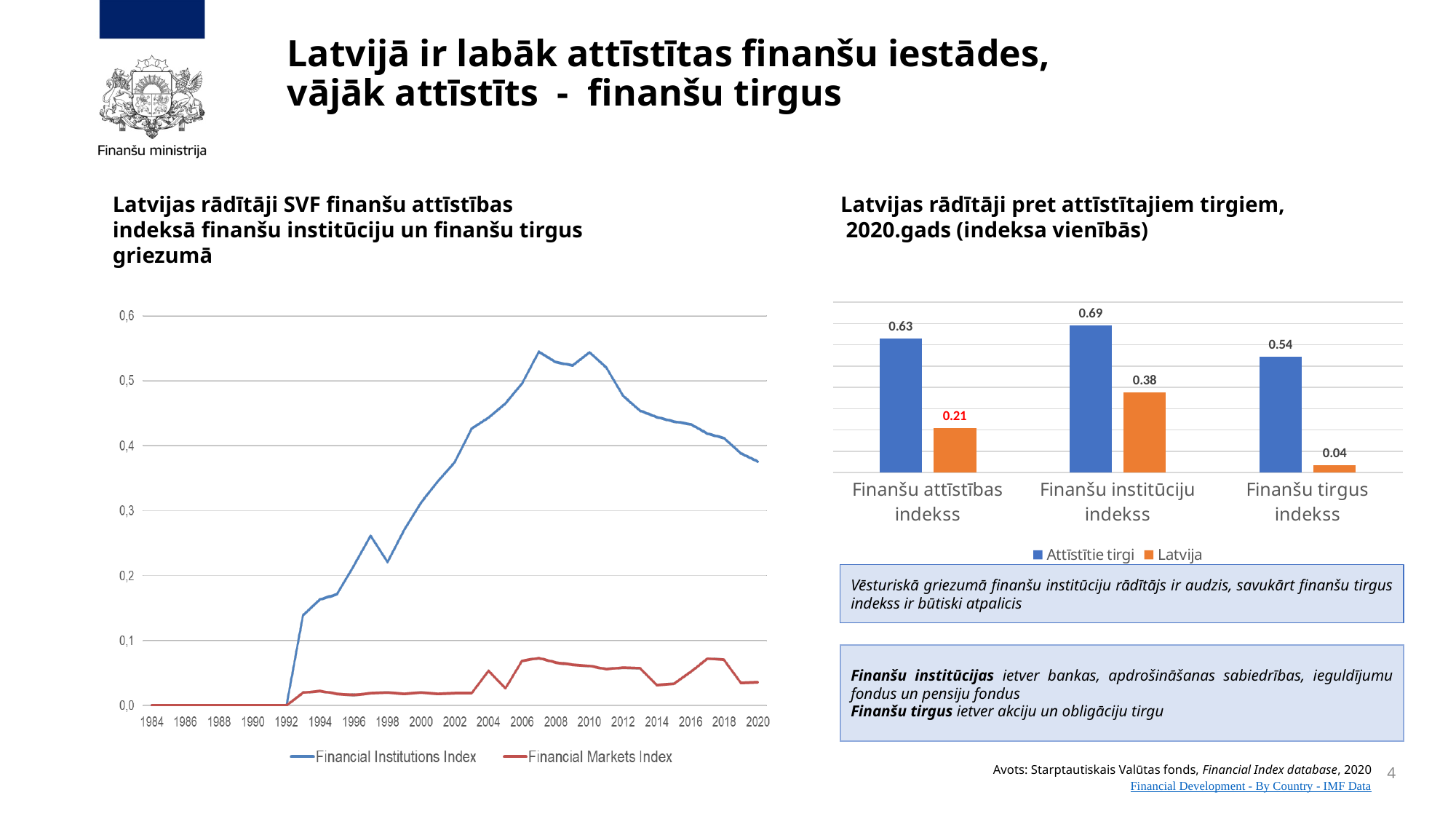
In the right-hand chart (Latvijas rādītāji pret attīstītajiem tirgiem, 2020.gads), what is the value for Latvija in the Finanšu attīstības indekss category? 0.21 In the right-hand chart (Latvijas rādītāji pret attīstītajiem tirgiem, 2020.gads), what is the difference between Attīstītie tirgi and Latvija in the Finanšu tirgus indekss category? 0.50 In the left-hand chart (Latvijas rādītāji SVF finanšu attīstības indeksā), which series is higher in 2010, Financial Institutions Index or Financial Markets Index? Financial Institutions Index In the right-hand chart (Latvijas rādītāji pret attīstītajiem tirgiem, 2020.gads), what is the value for Latvija in the Finanšu tirgus indekss category? 0.04 In the right-hand chart (Latvijas rādītāji pret attīstītajiem tirgiem, 2020.gads), what is the value for Attīstītie tirgi in the Finanšu institūciju indekss category? 0.69 In the right-hand chart (Latvijas rādītāji pret attīstītajiem tirgiem, 2020.gads), which category has the highest value for Attīstītie tirgi? Finanšu institūciju indekss In the left-hand chart (Latvijas rādītāji SVF finanšu attīstības indeksā), is the value of the Financial Institutions Index in 2020 greater or less than 0.3? greater In the right-hand chart (Latvijas rādītāji pret attīstītajiem tirgiem, 2020.gads), what is the difference between Attīstītie tirgi and Latvija in the Finanšu institūciju indekss category? 0.31 What kind of chart is the left-hand chart (Latvijas rādītāji SVF finanšu attīstības indeksā)? Line chart In the right-hand chart (Latvijas rādītāji pret attīstītajiem tirgiem, 2020.gads), which category has the lowest value for Latvija? Finanšu tirgus indekss In the right-hand chart (Latvijas rādītāji pret attīstītajiem tirgiem, 2020.gads), how many series does the legend list? 2 In the right-hand chart (Latvijas rādītāji pret attīstītajiem tirgiem, 2020.gads), how many categories are shown on the x axis? 3